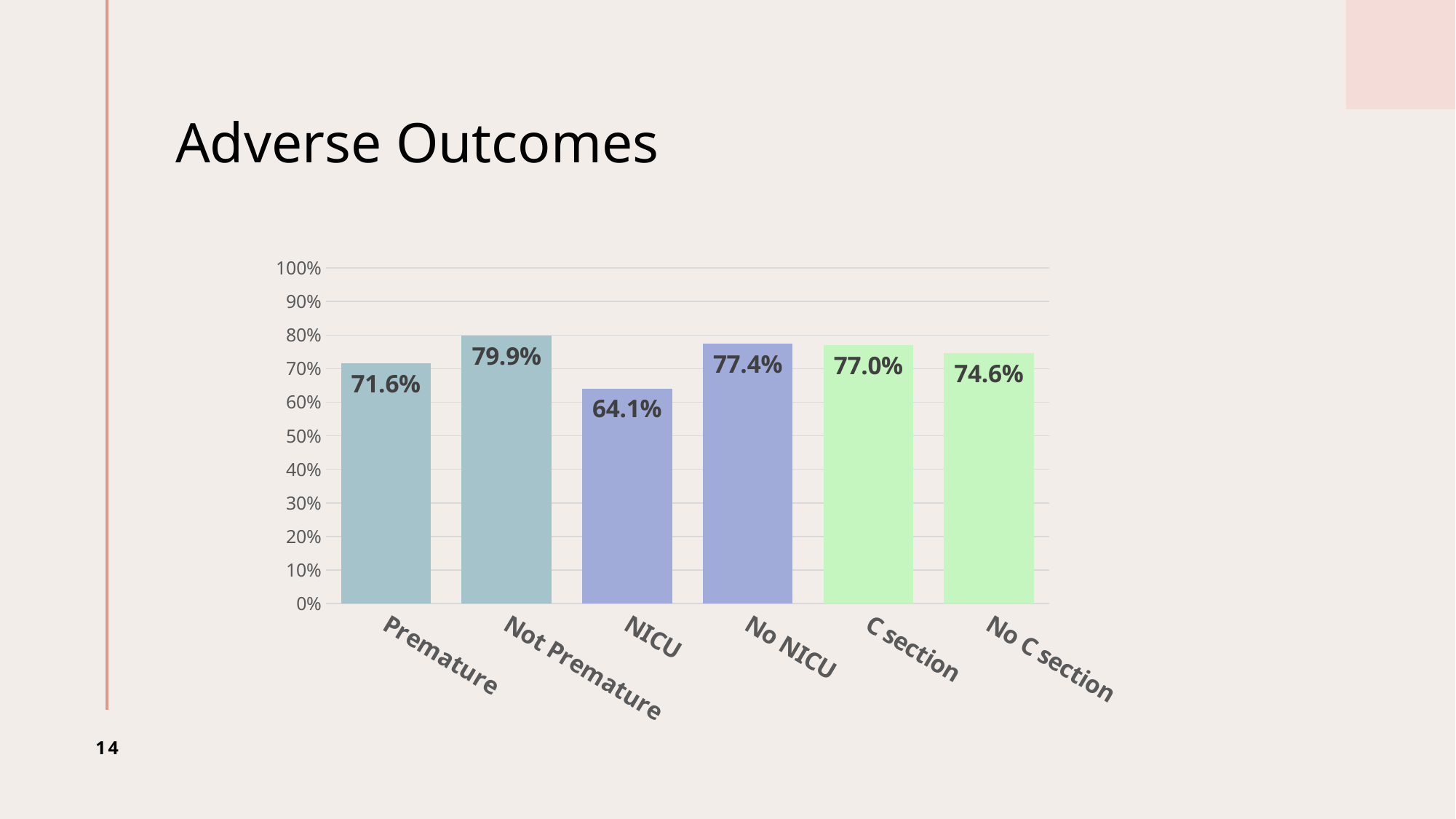
How many categories are shown on the x axis? 6 What is the value for NICU? 64.1% Is the value for NICU greater or less than 70%? less What kind of chart is shown on the slide? bar chart Which is larger, the value for C section or the value for No C section? C section What is the value for Premature? 71.6% What is the value for No C section? 74.6% Which category has the highest value? Not Premature What is the difference between the values for Not Premature and Premature? 8.3% What is the difference between the values for No NICU and NICU? 13.3% What is the title of the slide containing the chart? Adverse Outcomes Which category has the lowest value? NICU